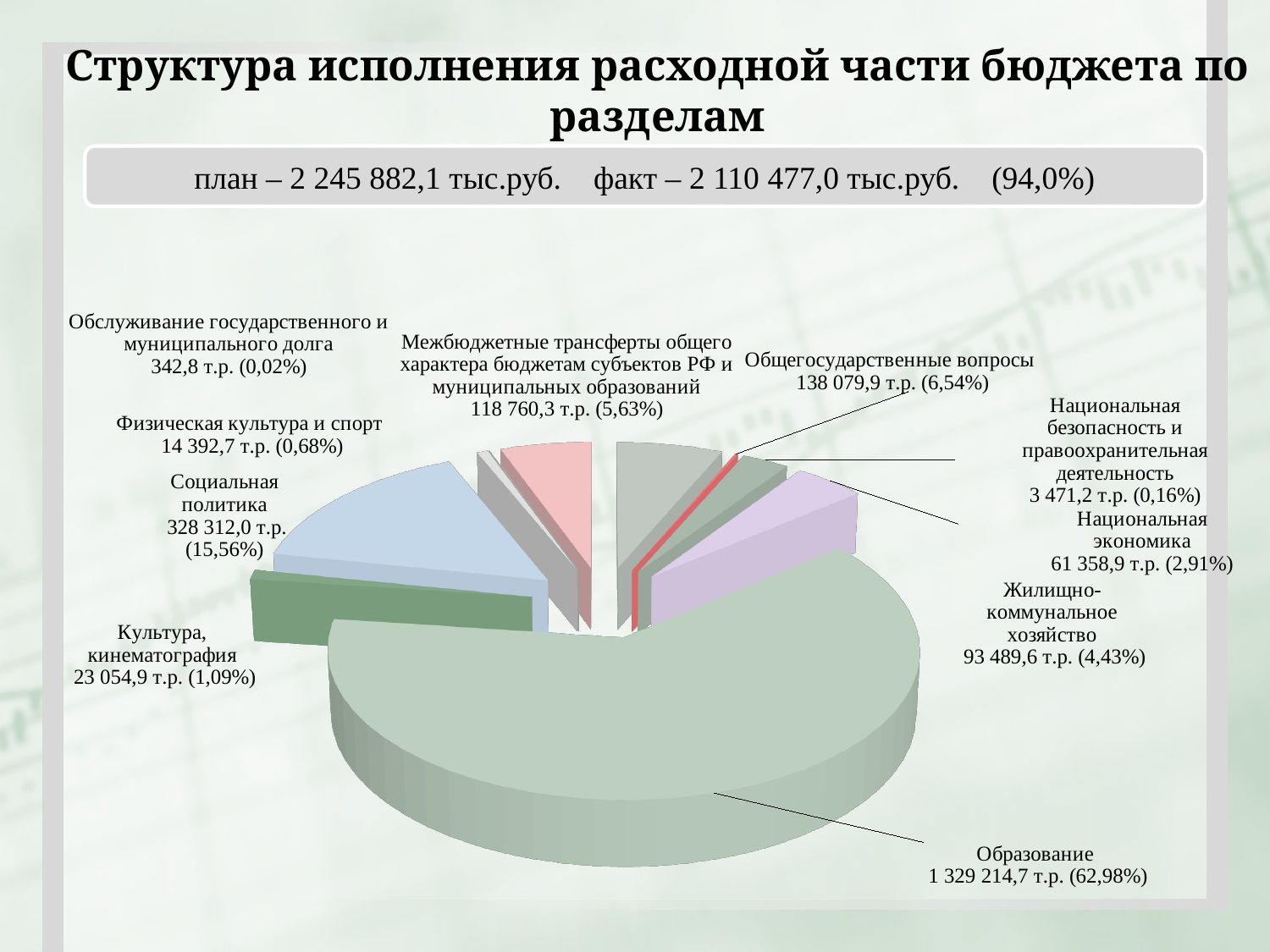
What is the title of the chart on the slide? Структура исполнения расходной части бюджета по разделам What is the value for Социальная политика? 328 312,0 т.р. What share of the pie does Национальная экономика account for? 2,91% Which section has the smallest share of the budget expenditure? Обслуживание государственного и муниципального долга What kind of chart is shown on the slide? Pie chart How many sections (slices) does the pie chart show? 10 What share of the pie does Образование account for? 62,98% Which section has the largest share of the budget expenditure? Образование What is the difference between Жилищно-коммунальное хозяйство and Национальная экономика? 32 130,7 т.р. What is the value for Жилищно-коммунальное хозяйство? 93 489,6 т.р. What is the difference between Культура, кинематография and Физическая культура и спорт? 8 662,2 т.р. Which is larger: Общегосударственные вопросы or Межбюджетные трансферты общего характера бюджетам субъектов РФ и муниципальных образований? Общегосударственные вопросы